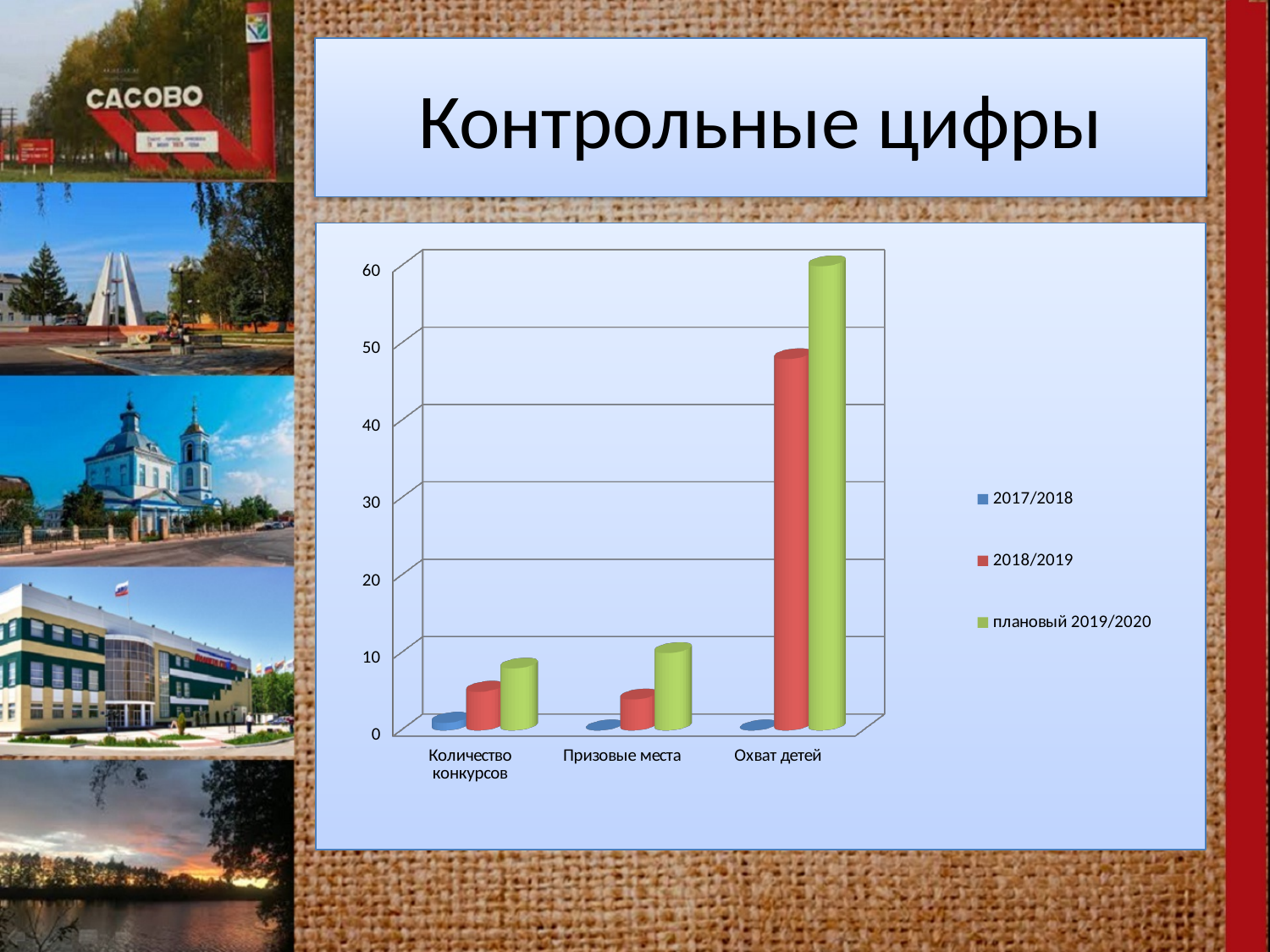
For the Охват детей category, which series is larger: 2018/2019 or плановый 2019/2020? плановый 2019/2020 Is the value for Охват детей in the плановый 2019/2020 series greater or less than 50? greater What kind of chart is shown on the slide? bar chart How many categories are shown on the x axis? 3 What colour represents the 2018/2019 series in the legend? red For the 2018/2019 series, which is larger: Охват детей or Призовые места? Охват детей Which category has the highest value for the 2018/2019 series? Охват детей Is the value for Охват детей in the 2018/2019 series greater or less than 40? greater Which category has the highest value for the плановый 2019/2020 series? Охват детей Is the value for Количество конкурсов in the 2018/2019 series greater or less than 10? less What is the title of the slide with the chart? Контрольные цифры How many series does the legend list? 3